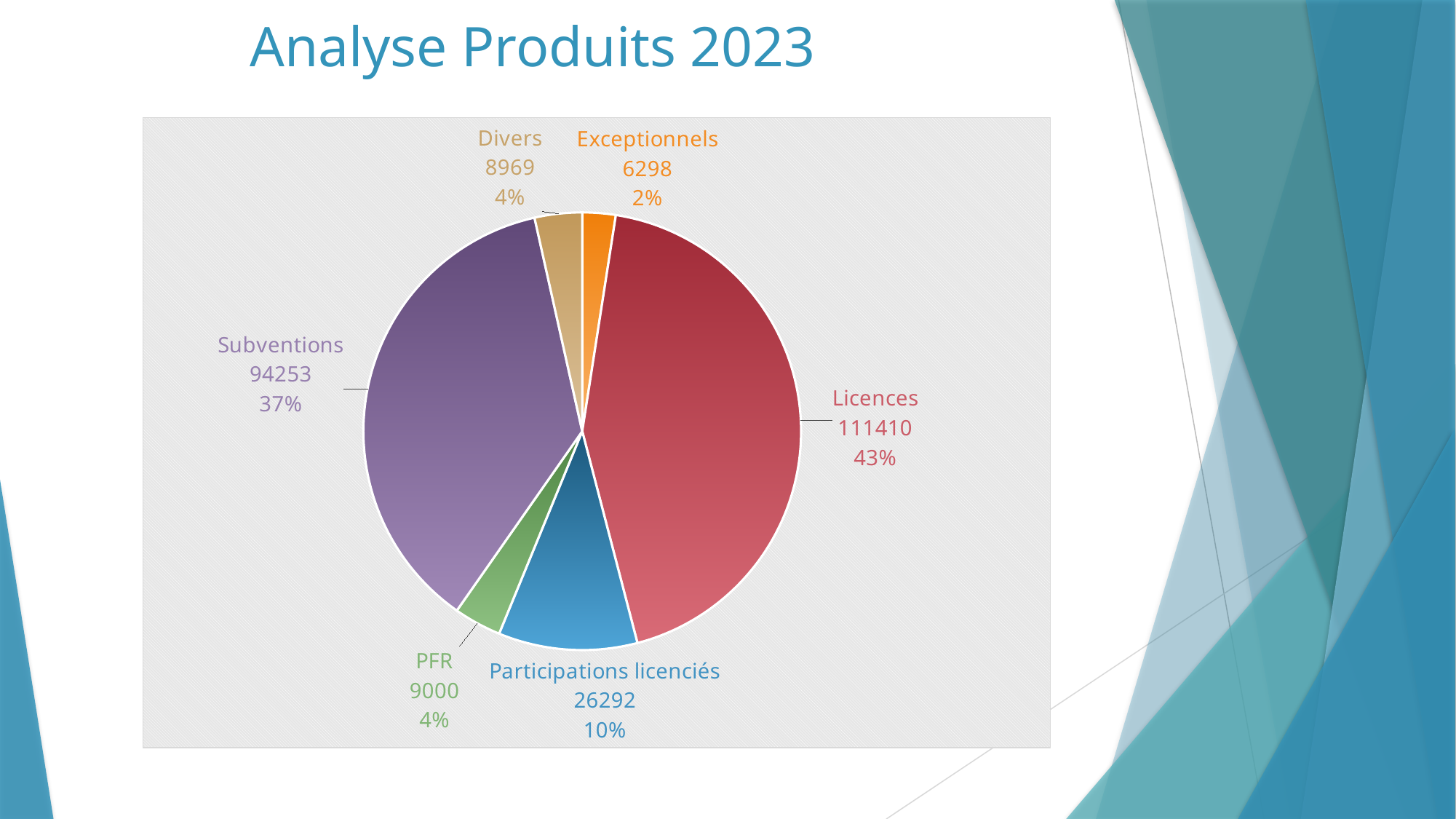
What share of the pie does Subventions represent? 37% What is the value for Licences? 111410 Which category has the largest slice? Licences What is the value for Subventions? 94253 Which is larger, the value for PFR or the value for Divers? PFR Which category has the smallest slice? Exceptionnels What is the value for Participations licenciés? 26292 What share of the pie does Participations licenciés represent? 10% How many categories are shown in the pie chart? 6 What is the value for Exceptionnels? 6298 What is the difference between the values for Licences and Subventions? 17157 What type of chart is shown on the slide? pie chart